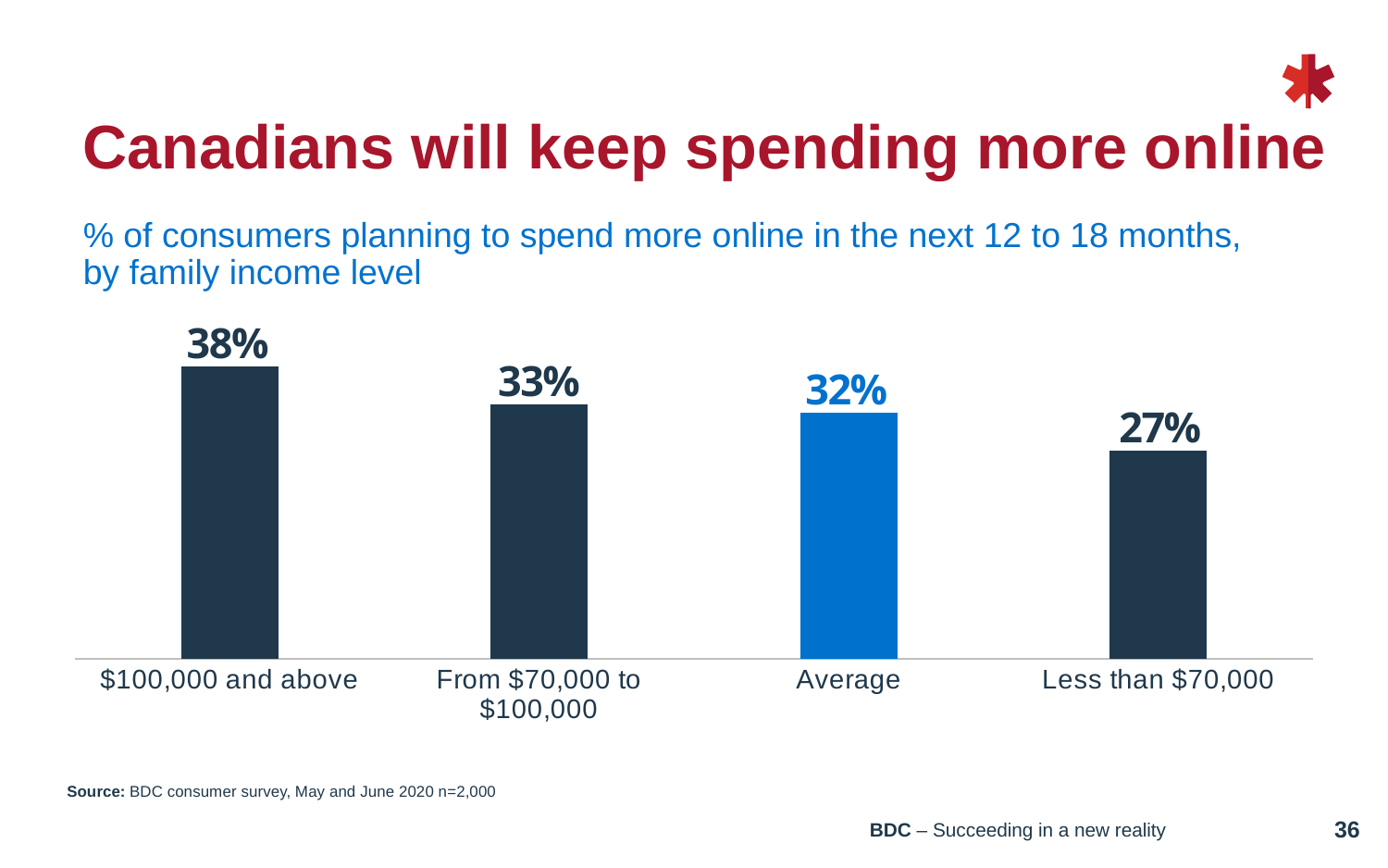
What is the difference between the '$100,000 and above' group and the 'Less than $70,000' group? 11 percentage points Do the values rise or fall moving from left to right across the chart? Fall What is the Average value shown on the chart? 32% What is the value shown for the 'From $70,000 to $100,000' income group? 33% What percentage is shown for the 'Less than $70,000' income group? 27% Which bar is shown in a different (lighter blue) colour from the others? Average Which income group has the highest share of consumers planning to spend more online? $100,000 and above Which is larger: the value for 'From $70,000 to $100,000' or the Average? From $70,000 to $100,000 What type of chart is shown on the slide? Bar chart What percentage of consumers with family income of $100,000 and above plan to spend more online? 38% How many categories are shown on the chart? 4 Which category has the lowest value on the chart? Less than $70,000